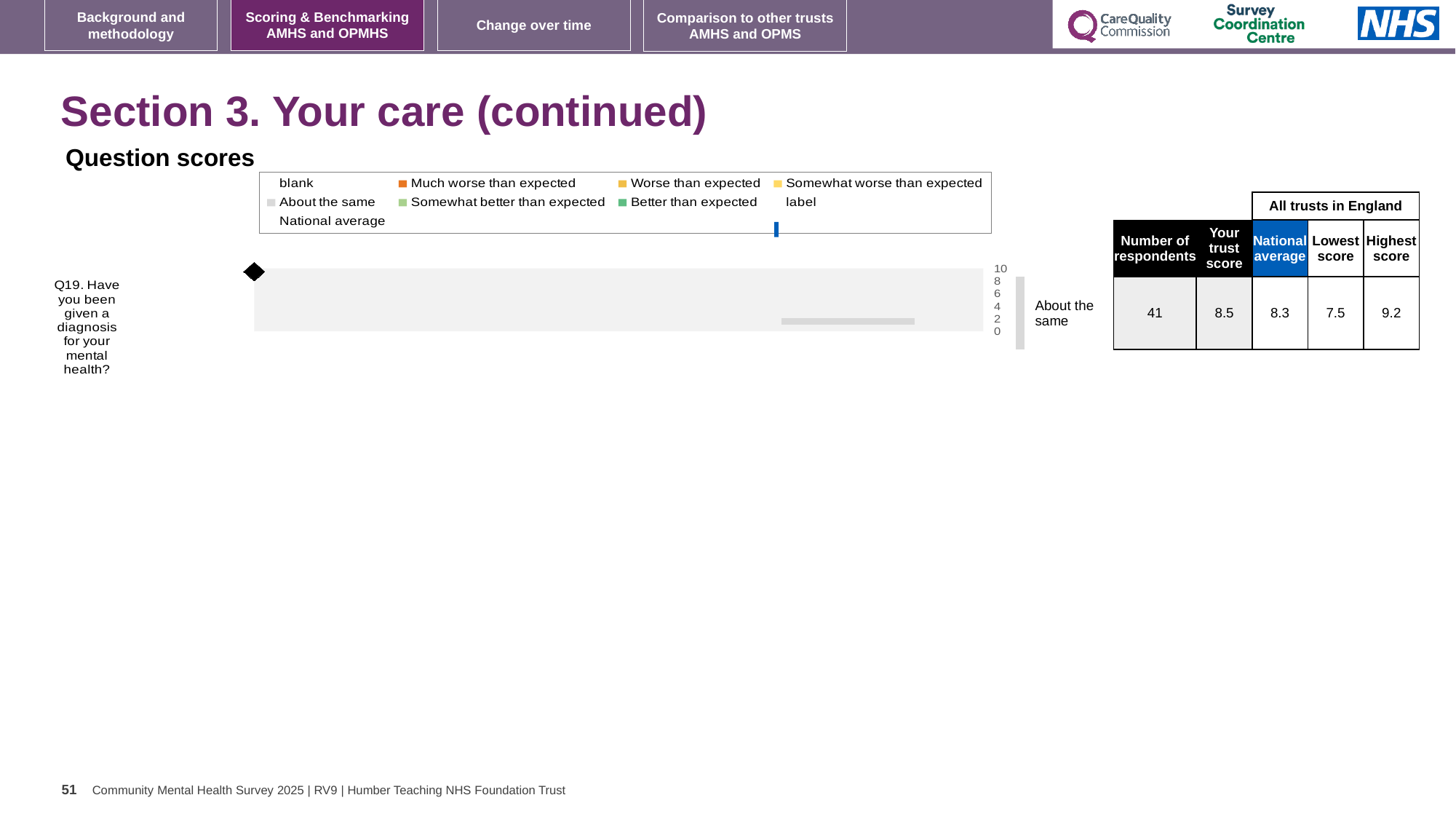
Is the trust score for Q19 larger or smaller than the national average? larger In the table beside the chart, what is the lowest score among all trusts in England for Q19? 7.5 Which question is plotted in the Question scores chart? Q19. Have you been given a diagnosis for your mental health? What comparison category label is shown next to the bar for Q19? About the same How many survey questions are plotted in the Question scores chart? 1 What is the highest value shown on the chart's score axis? 10 In the table beside the chart, what is the national average for Q19? 8.3 What kind of chart is shown under 'Question scores'? bar chart What is the difference between the highest score and the lowest score for Q19 in the table beside the chart? 1.7 In the table beside the chart, what is the trust score for Q19? 8.5 In the table beside the chart, what is the highest score among all trusts in England for Q19? 9.2 How many respondents answered Q19 according to the table beside the chart? 41